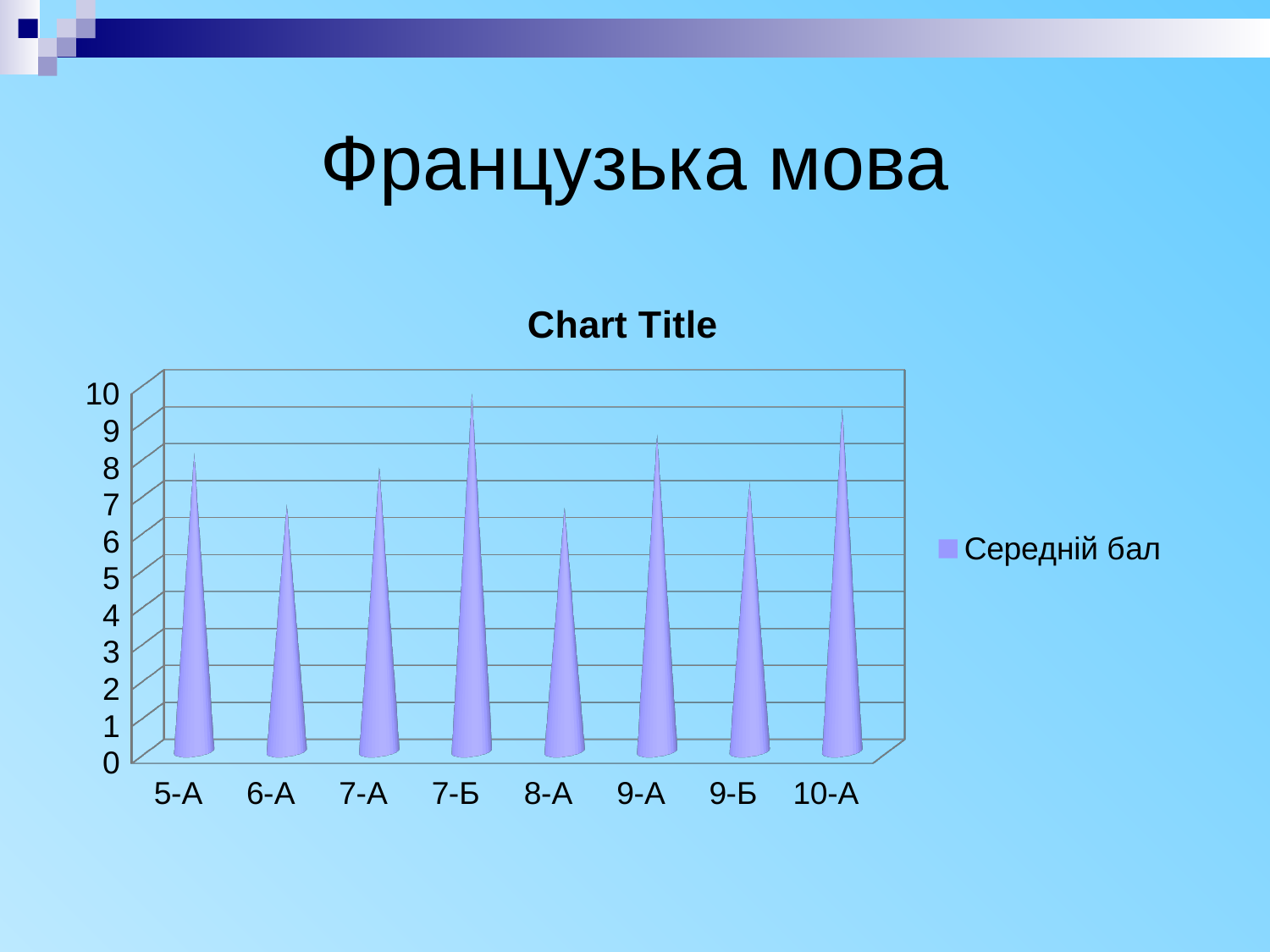
Is the value for 9-Б greater or less than 8? less Which class has the highest average score in the chart? 7-Б How many classes (categories) are shown on the x axis of the chart? 8 Which is larger, the value for 10-А or the value for 9-Б? 10-А Is the value for 10-А greater or less than 9? greater Is the value for 6-А greater or less than 8? less What kind of chart is shown on the slide? bar chart Which is larger, the value for 9-А or the value for 8-А? 9-А What is the name of the series shown in the chart legend? Середній бал How many series does the chart legend list? 1